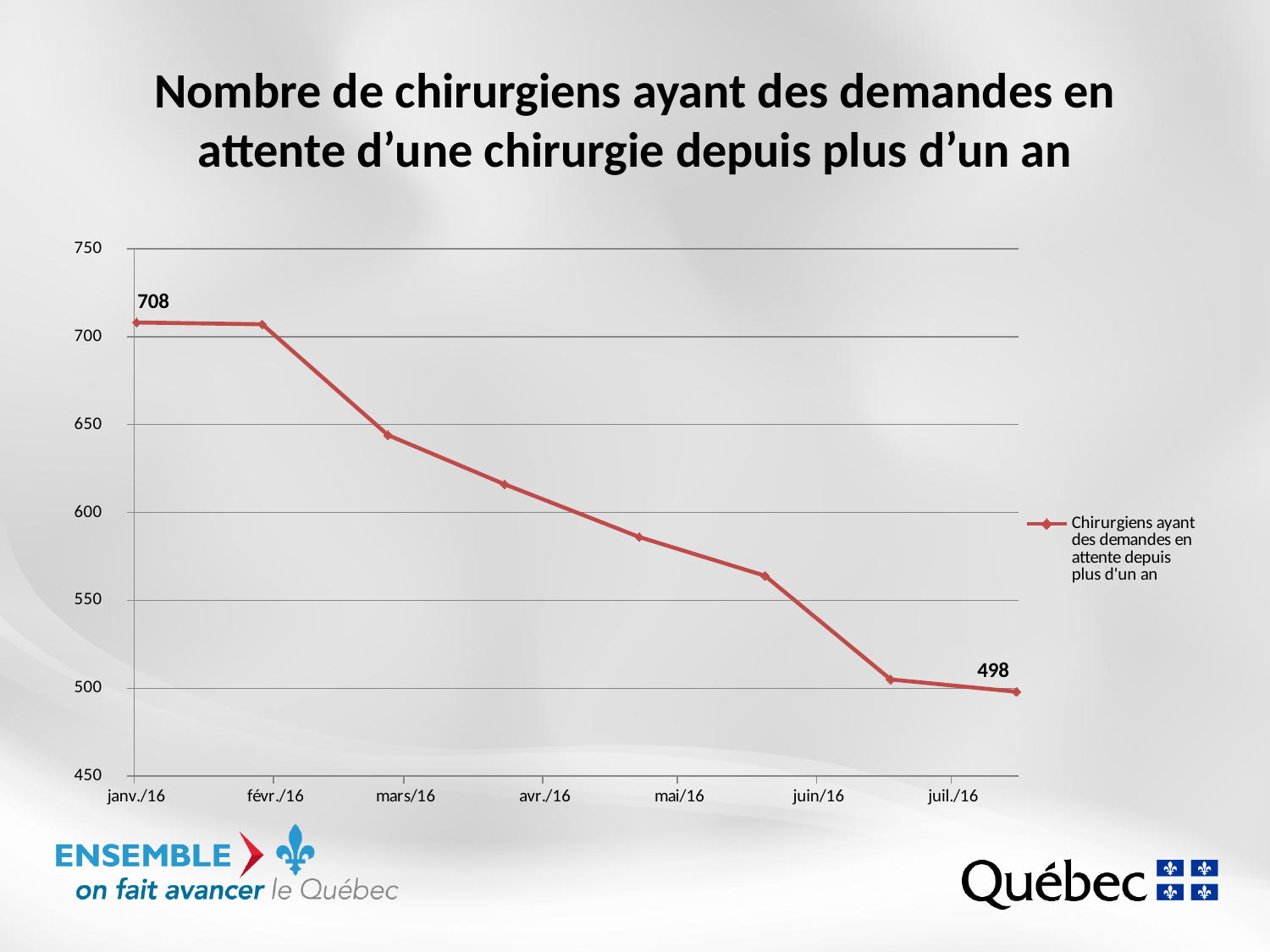
Do the values rise or fall from janv./16 to the end of the series? fall What type of chart is shown on the slide? line chart Is the value of the third data point (around mars/16) greater or less than 600? greater What is the legend entry for the plotted series? Chirurgiens ayant des demandes en attente depuis plus d'un an Which is larger, the value at janv./16 or the value of the last data point? janv./16 What is the difference between the first labelled value (708) and the last labelled value (498)? 210 What is the value of the last data point on the line? 498 How many data points are plotted on the line? 8 Which data point has the highest value? janv./16 (708) How many series does the legend list? 1 What is the value of the first data point, at janv./16? 708 Is the value at févr./16 greater or less than 700? greater